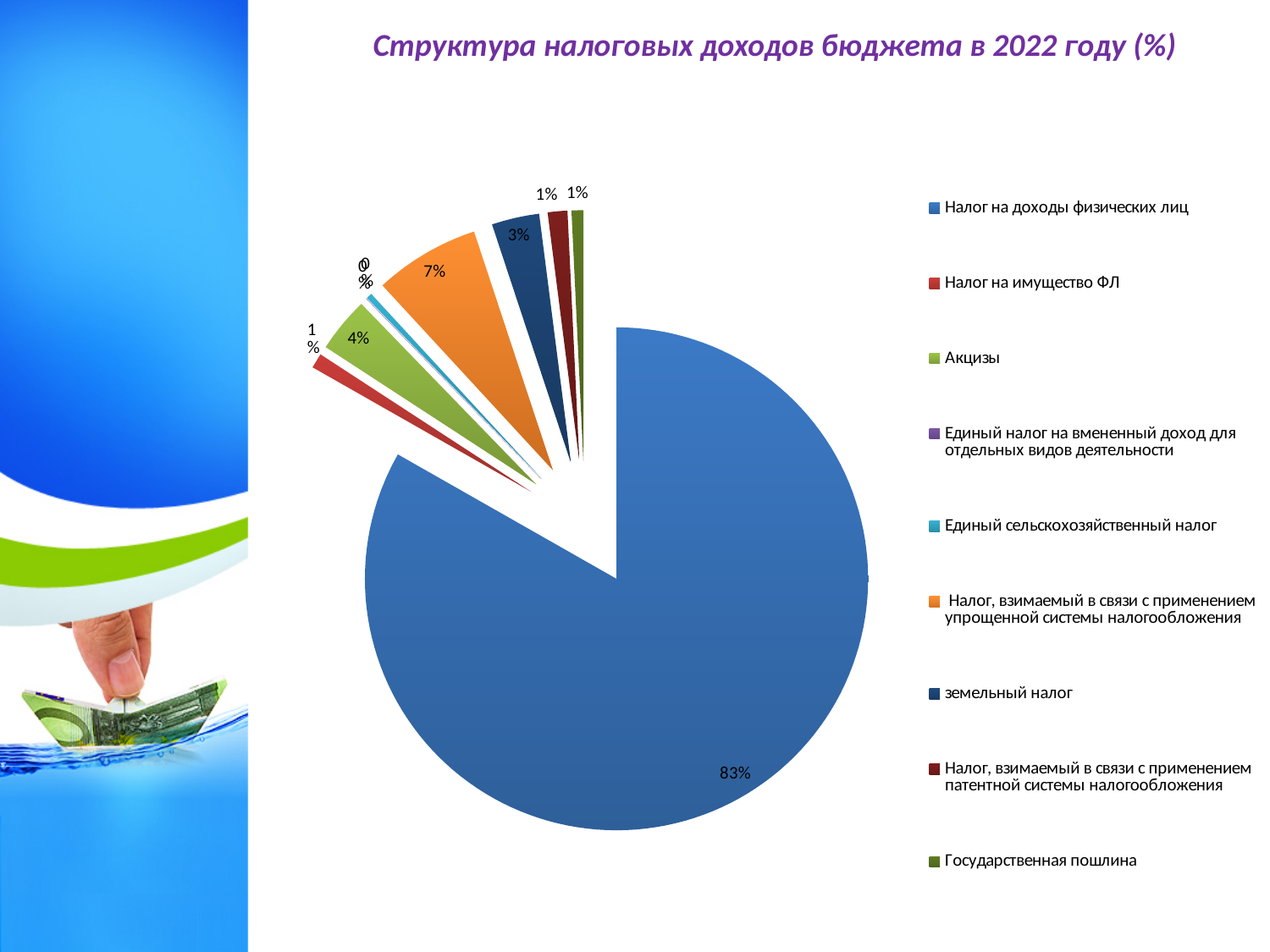
Which category has the largest slice of the pie? Налог на доходы физических лиц What is the title of the chart? Структура налоговых доходов бюджета в 2022 году (%) What share of the pie is Государственная пошлина? 1% What share of the pie is Налог на доходы физических лиц? 83% What share of the pie is Налог, взимаемый в связи с применением упрощенной системы налогообложения? 7% What kind of chart is shown on the slide? pie chart Which is larger: the slice for Акцизы or the slice for земельный налог? Акцизы How many entries does the chart legend list? 9 What colour is the slice for Налог на доходы физических лиц? blue What is the difference between the share for Налог на доходы физических лиц and the share for Налог, взимаемый в связи с применением упрощенной системы налогообложения? 76%